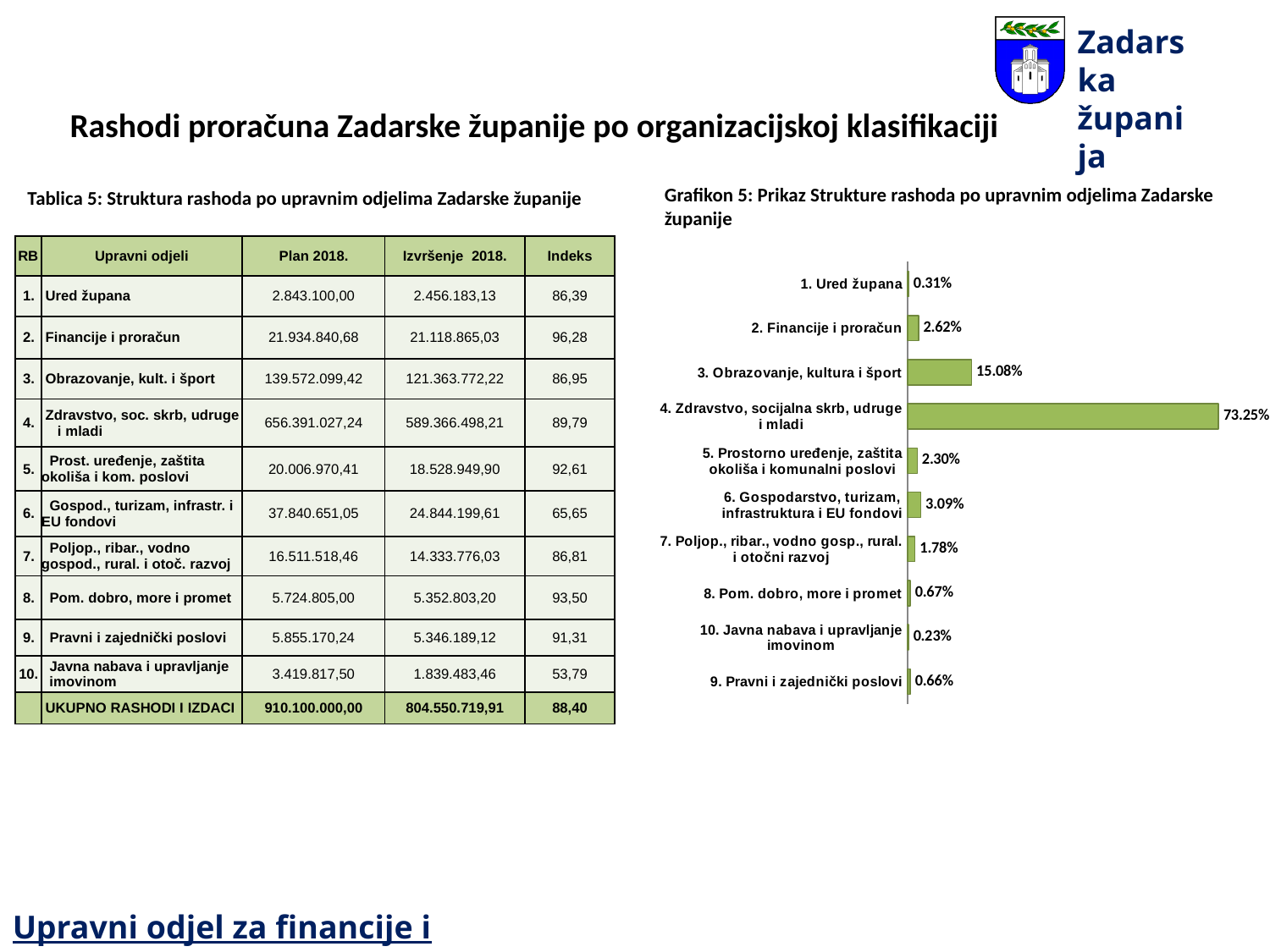
What is the value shown for "4. Zdravstvo, socijalna skrb, udruge i mladi" in the chart? 73.25% What is the difference between the values for "6. Gospodarstvo, turizam, infrastruktura i EU fondovi" and "2. Financije i proračun"? 0.47% Which has a larger value: "2. Financije i proračun" or "5. Prostorno uređenje, zaštita okoliša i komunalni poslovi"? 2. Financije i proračun What is the value shown for "1. Ured župana" in the chart? 0.31% What is the difference between the values for "4. Zdravstvo, socijalna skrb, udruge i mladi" and "3. Obrazovanje, kultura i šport"? 58.17% What kind of chart is shown on the slide? Bar chart Which category has the highest value in the chart? 4. Zdravstvo, socijalna skrb, udruge i mladi What is the title of the chart on the slide? Grafikon 5: Prikaz Strukture rashoda po upravnim odjelima Zadarske županije Which category has the lowest value in the chart? 10. Javna nabava i upravljanje imovinom What is the value shown for "3. Obrazovanje, kultura i šport" in the chart? 15.08% What is the value shown for "6. Gospodarstvo, turizam, infrastruktura i EU fondovi" in the chart? 3.09% How many categories are shown in the chart? 10